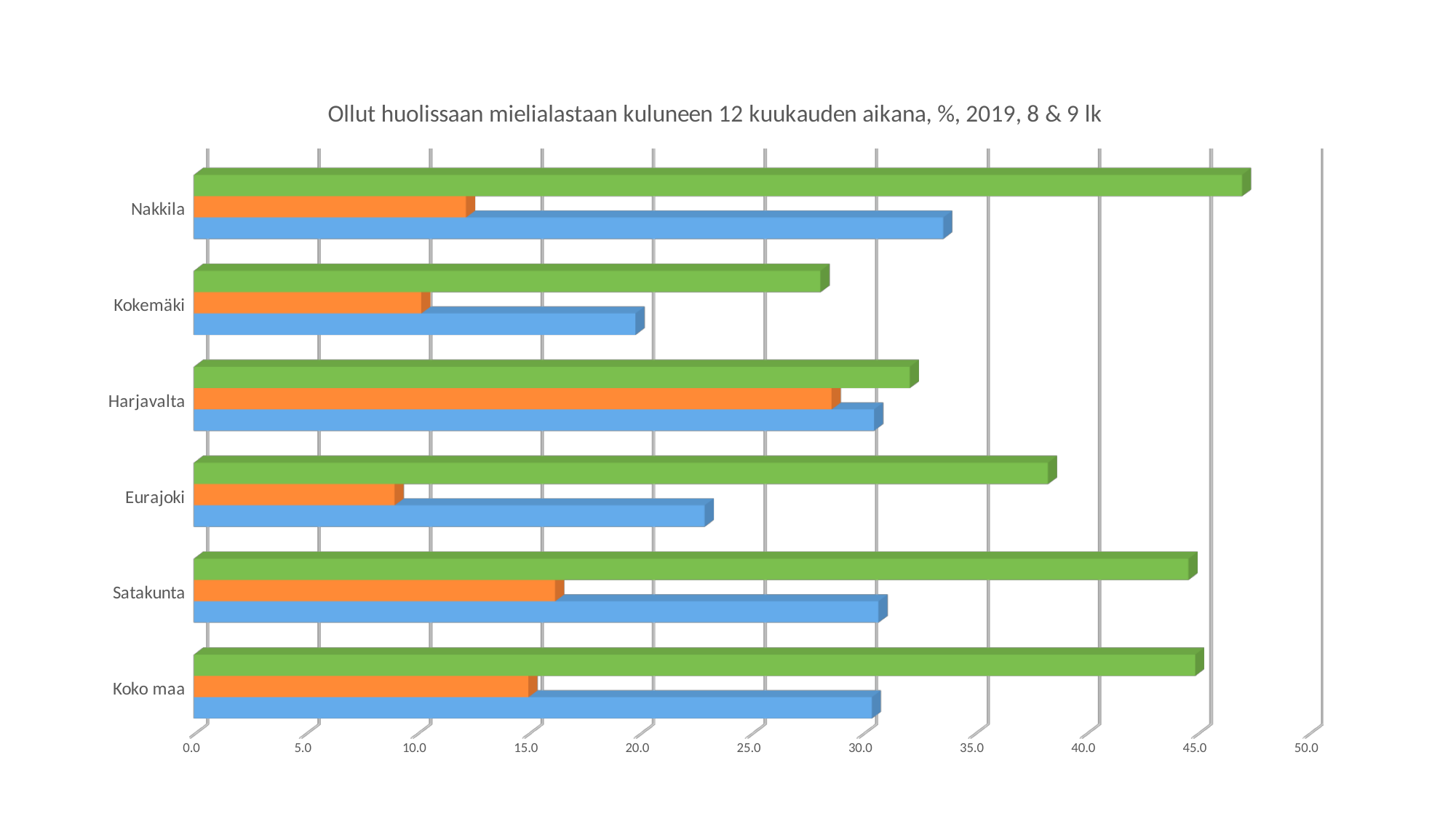
How many bars (series) are shown for each category in the chart? 3 How many categories are shown on the vertical axis of the chart? 6 Which category has the longest orange bar? Harjavalta Which category has the longest green bar? Nakkila What is the title of the chart? Ollut huolissaan mielialastaan kuluneen 12 kuukauden aikana, %, 2019, 8 & 9 lk What kind of chart is shown on the slide? bar chart For Nakkila, which is larger: the green bar or the blue bar? the green bar Which category has the shortest blue bar? Kokemäki Is the value of the orange bar for Kokemäki greater or less than 15.0? less Which category has the shortest green bar? Kokemäki Is the value of the blue bar for Eurajoki greater or less than 20.0? greater Is the value of the green bar for Nakkila greater or less than 45.0? greater